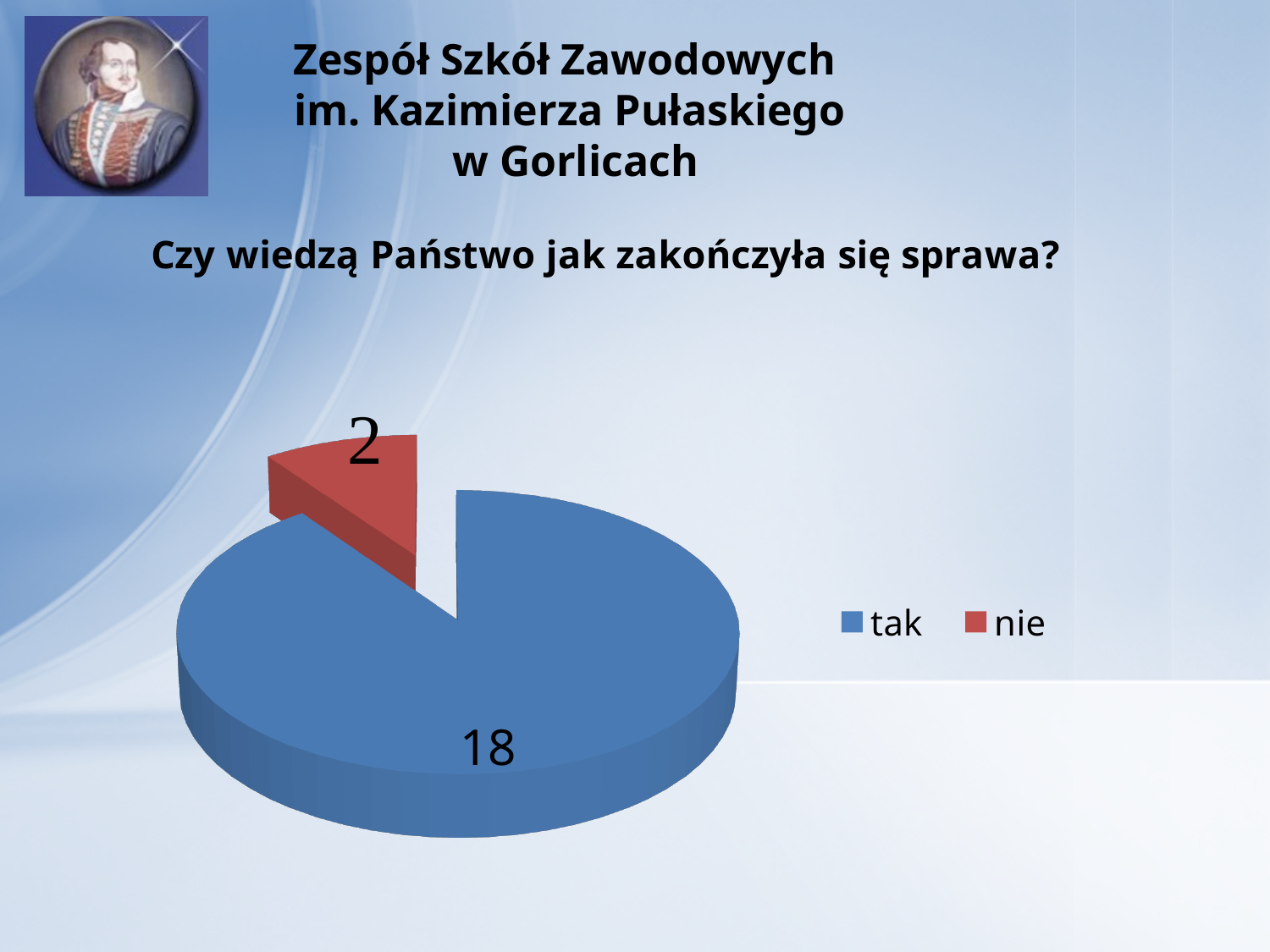
How many slices does the pie chart have? 2 Which is larger, the value for "tak" or the value for "nie"? tak What is the difference between the values for "tak" and "nie"? 16 What is the value for "nie"? 2 What is the total of all slices in the pie chart? 20 What colour is the "nie" slice? red Which category has the largest slice? tak What is the value for "tak"? 18 What type of chart is shown on the slide? pie chart Which category has the smallest slice? nie What share of the pie does the "tak" slice represent? 90% How many entries does the legend list? 2